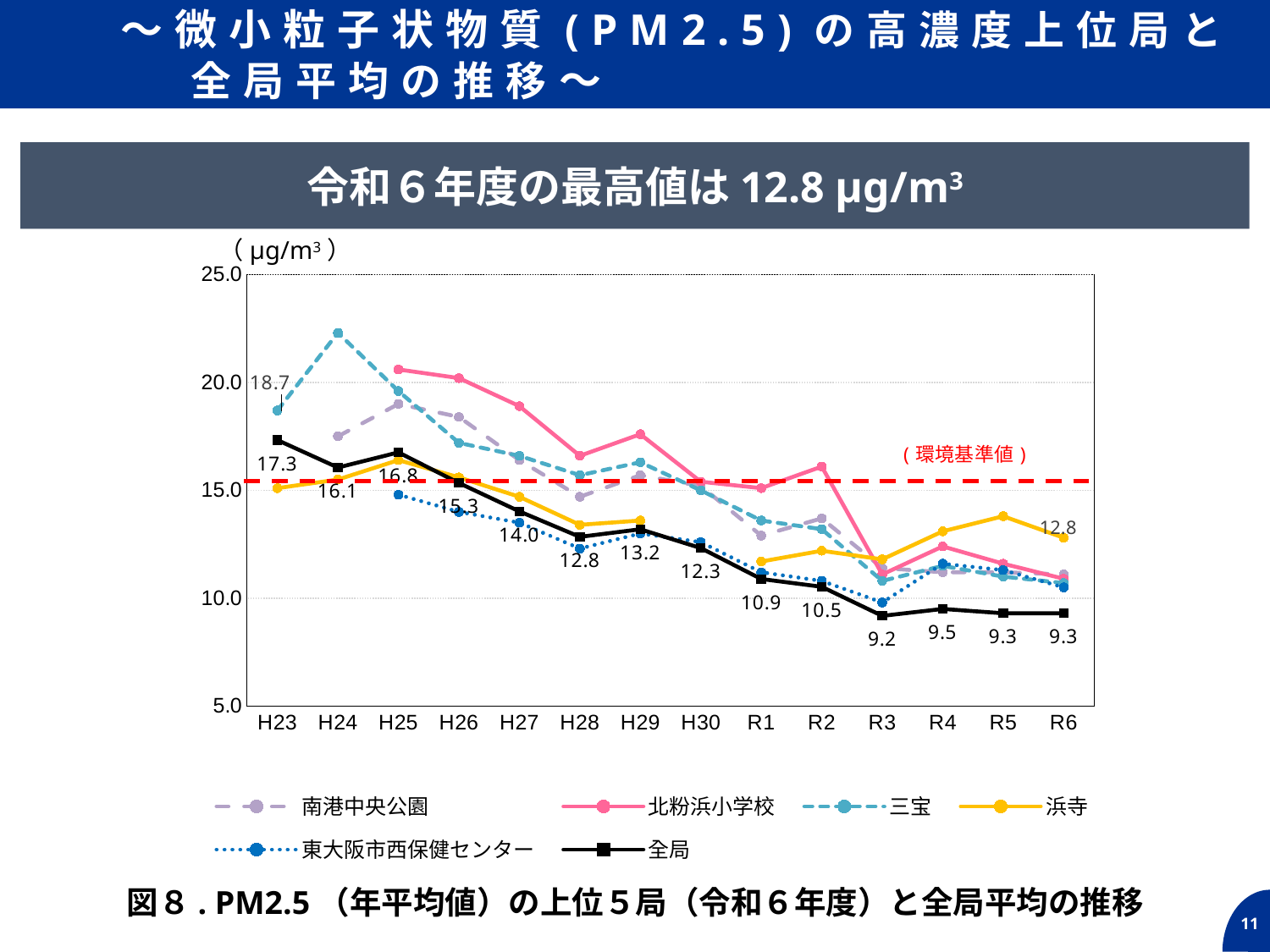
What is the difference between the 全局 values at H23 and R6? 8.0 How many series does the legend list? 6 What is the value for 全局 at R3? 9.2 Is the 全局 value at H24 larger or smaller than at H25? smaller What is the value for 全局 at H28? 12.8 Is the value for 北粉浜小学校 at H25 greater or less than 20.0? greater Which year has the lowest 全局 value? R3 What kind of chart is shown? line chart What is the value for 全局 at R6? 9.3 What is the value for 浜寺 at R6? 12.8 Which year has the highest 全局 value? H23 What is the value for 全局 at H23? 17.3